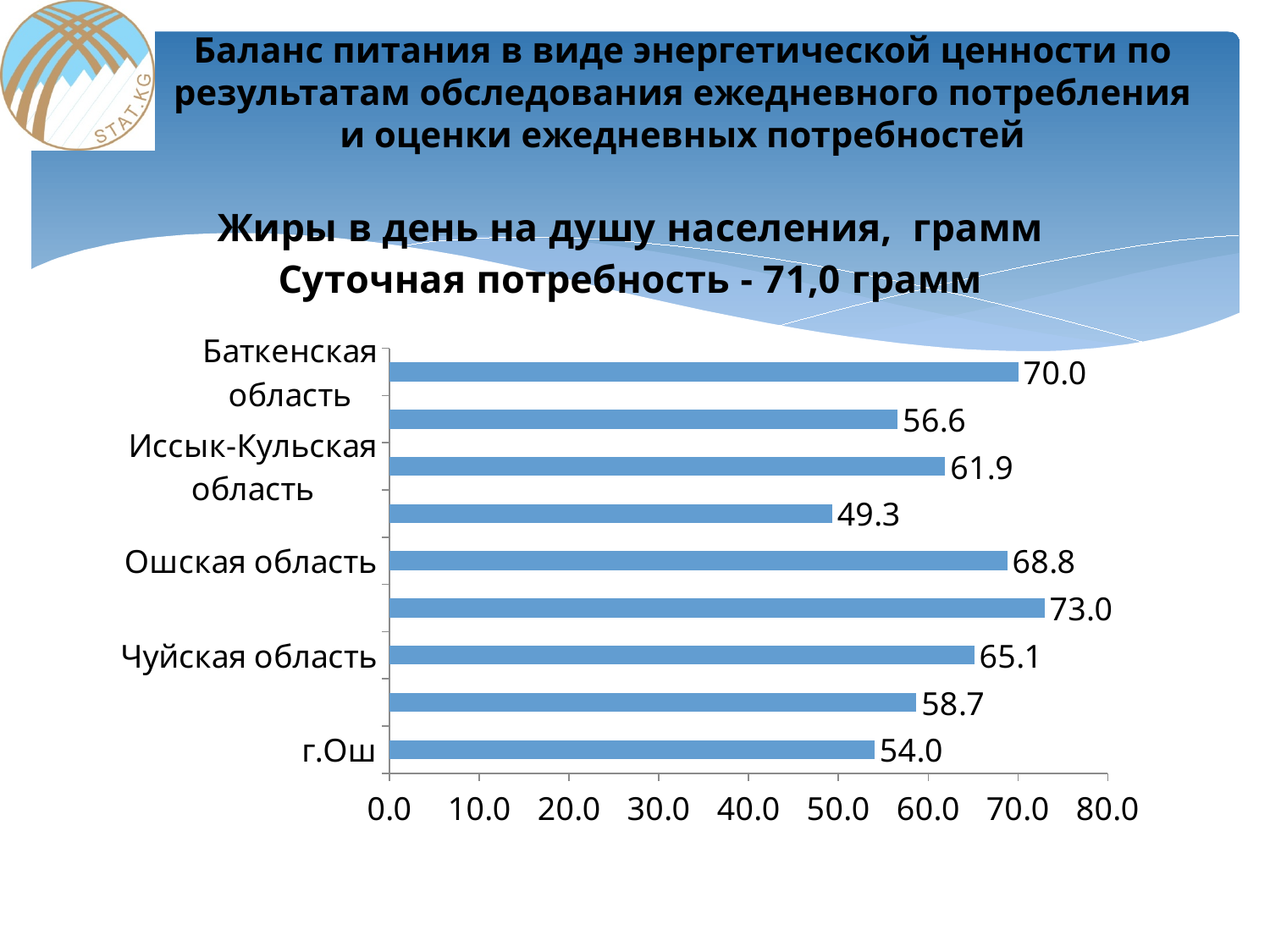
What is the value for Чуйская область? 65.1 What is the value for Ошская область? 68.8 Is the value for г.Ош greater or less than 60.0? less What is the value for Баткенская область? 70.0 Which is larger, the value for Ошская область or the value for Чуйская область? Ошская область What is the value for Иссык-Кульская область? 61.9 How many bars are plotted on the chart? 9 What is the difference between the values for Баткенская область and г.Ош? 16.0 What is the highest value shown on the chart? 73.0 What is the lowest value shown on the chart? 49.3 What is the value for г.Ош? 54.0 What kind of chart is shown on the slide? bar chart